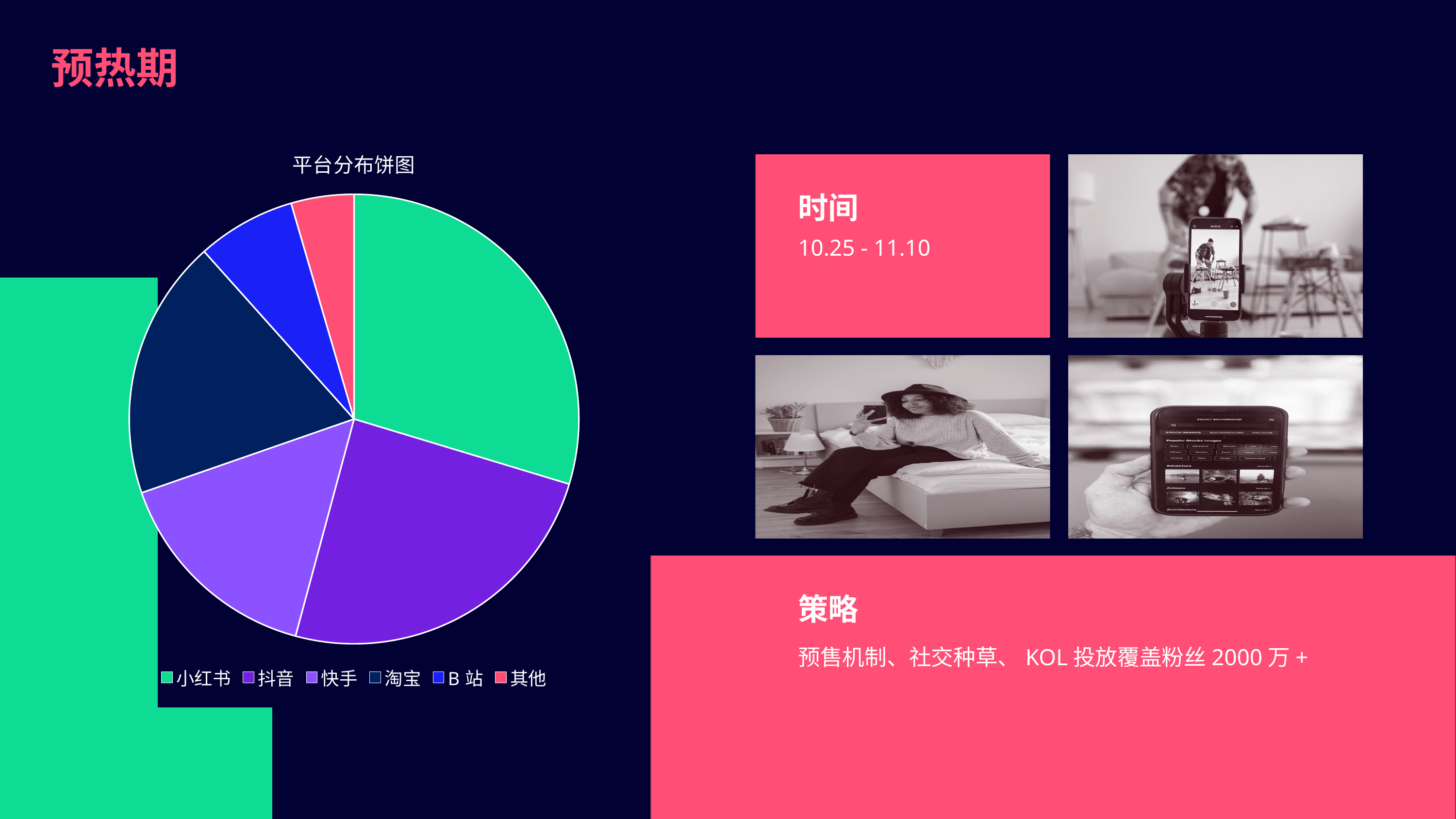
How many slices does the pie chart have? 6 How many entries does the chart legend list? 6 Which slice is larger, B 站 or 其他? B 站 Which slice is larger, 小红书 or 抖音? 小红书 What kind of chart is shown on the slide? pie chart Which platform has the smallest slice of the pie chart? 其他 Which slice is larger, 抖音 or 快手? 抖音 Which platform is shown in green in the pie chart? 小红书 Which platform has the largest slice of the pie chart? 小红书 What is the title of the chart? 平台分布饼图